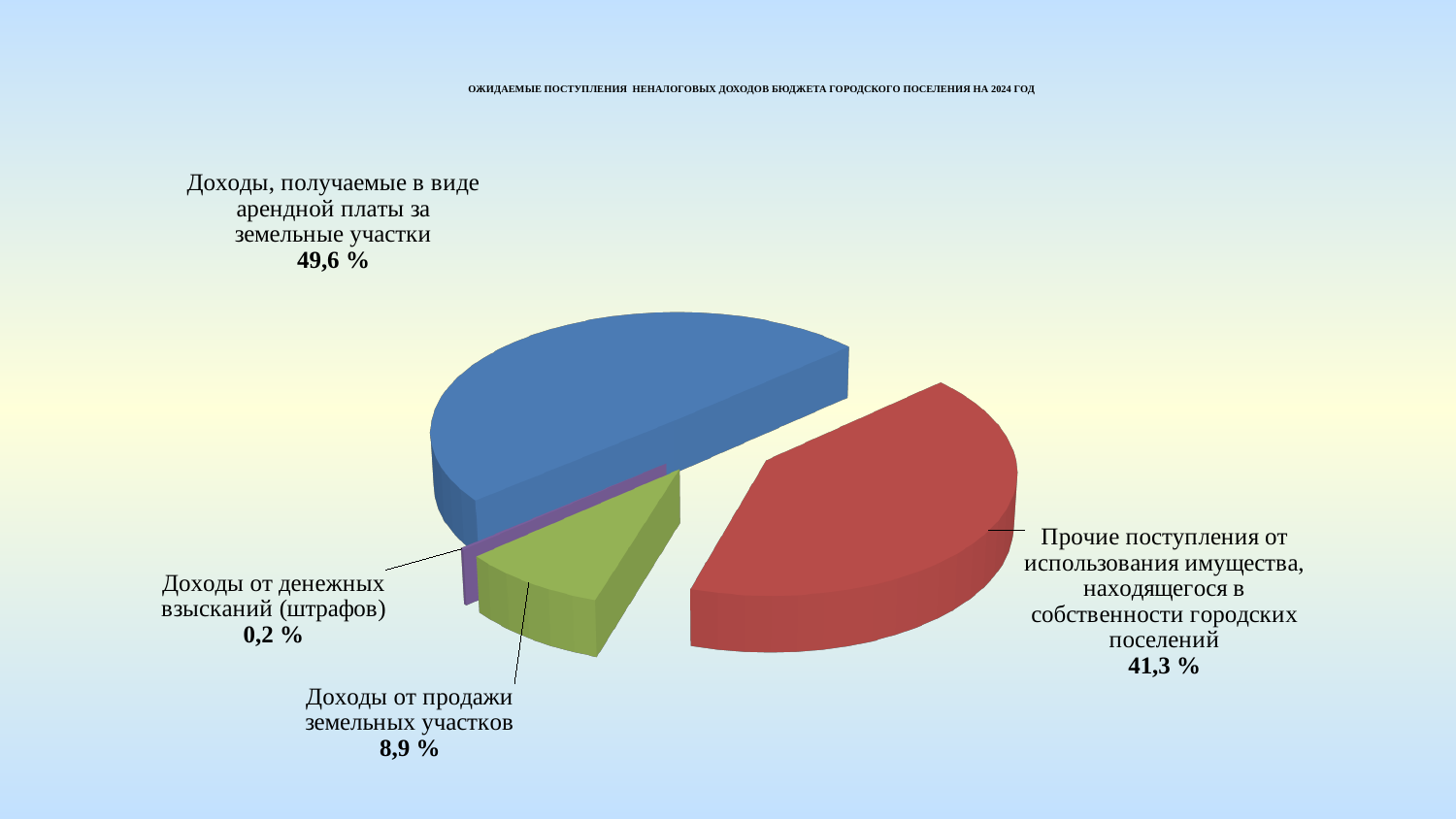
What share is shown for 'Прочие поступления от использования имущества, находящегося в собственности городских поселений'? 41,3 % What year does the chart title say the expected non-tax budget revenues are for? 2024 What is the difference in percentage points between the share for rental income from land plots (49,6 %) and the share for other income from use of property (41,3 %)? 8,3 Which is larger: the share for 'Доходы от продажи земельных участков' or the share for 'Доходы от денежных взысканий (штрафов)'? Доходы от продажи земельных участков Which category has the smallest share of the pie? Доходы от денежных взысканий (штрафов) What kind of chart is shown on the slide? Pie chart How many slices does the pie chart have? 4 Which category has the largest share of the pie? Доходы, получаемые в виде арендной платы за земельные участки What share of the pie is labelled for 'Доходы, получаемые в виде арендной платы за земельные участки'? 49,6 % What share is shown for 'Доходы от денежных взысканий (штрафов)'? 0,2 % What colour is the slice representing 'Прочие поступления от использования имущества, находящегося в собственности городских поселений'? Red What share is shown for 'Доходы от продажи земельных участков'? 8,9 %